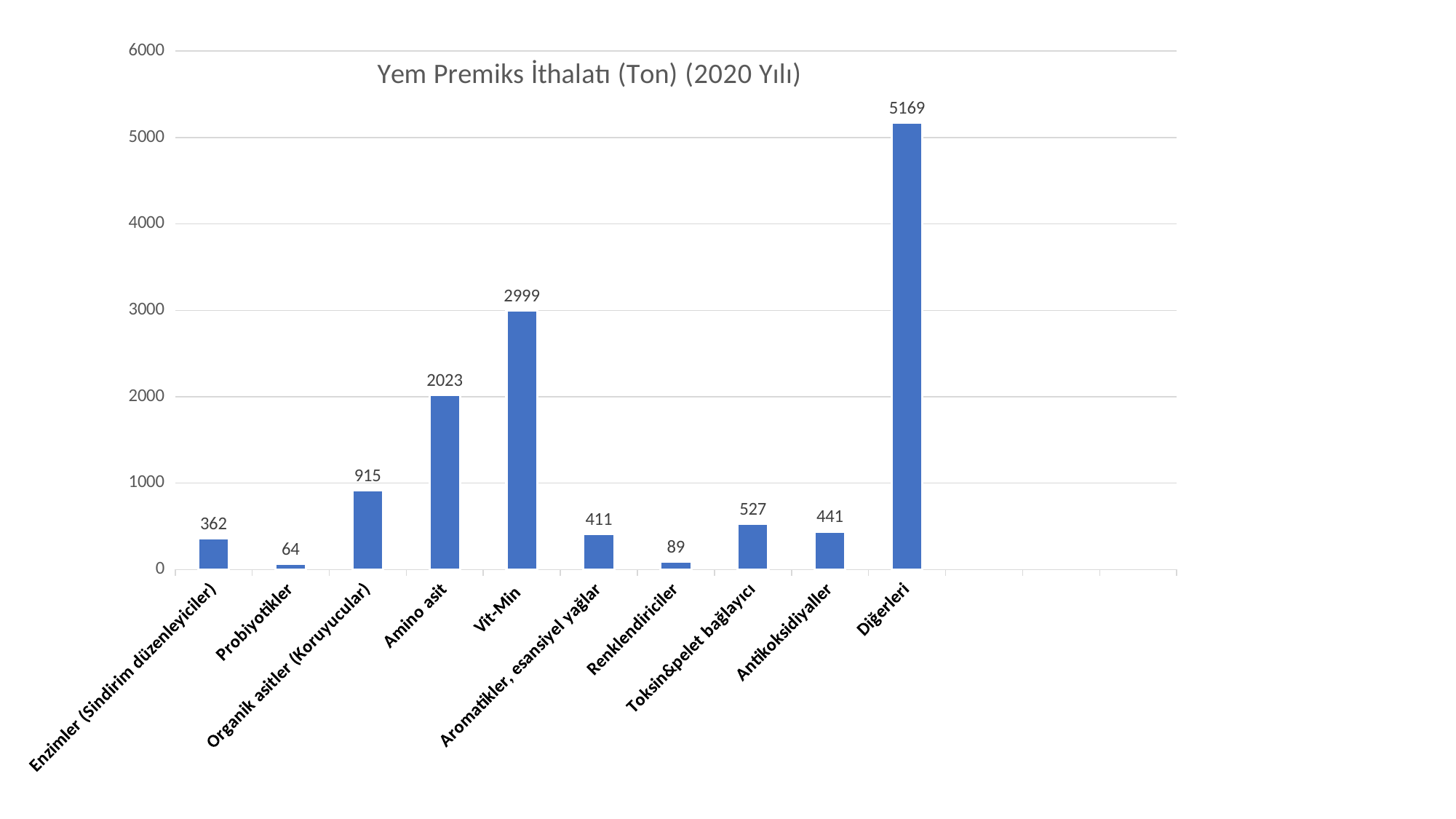
Which category has the lowest value? Probiyotikler Which category has the highest value? Diğerleri How many categories are shown on the x axis? 10 What is the value for Probiyotikler? 64 What is the value for Vit-Min? 2999 What kind of chart is this? bar chart Is the value for Organik asitler (Koruyucular) greater or less than 1000? less What is the value for Toksin&pelet bağlayıcı? 527 What is the title of the chart? Yem Premiks İthalatı (Ton) (2020 Yılı) What is the difference between the values for Vit-Min and Amino asit? 976 What is the difference between the values for Diğerleri and Enzimler (Sindirim düzenleyiciler)? 4807 Which is larger, the value for Antioksidiyaller or the value for Aromatikler, esansiyel yağlar? Antikoksidiyaller